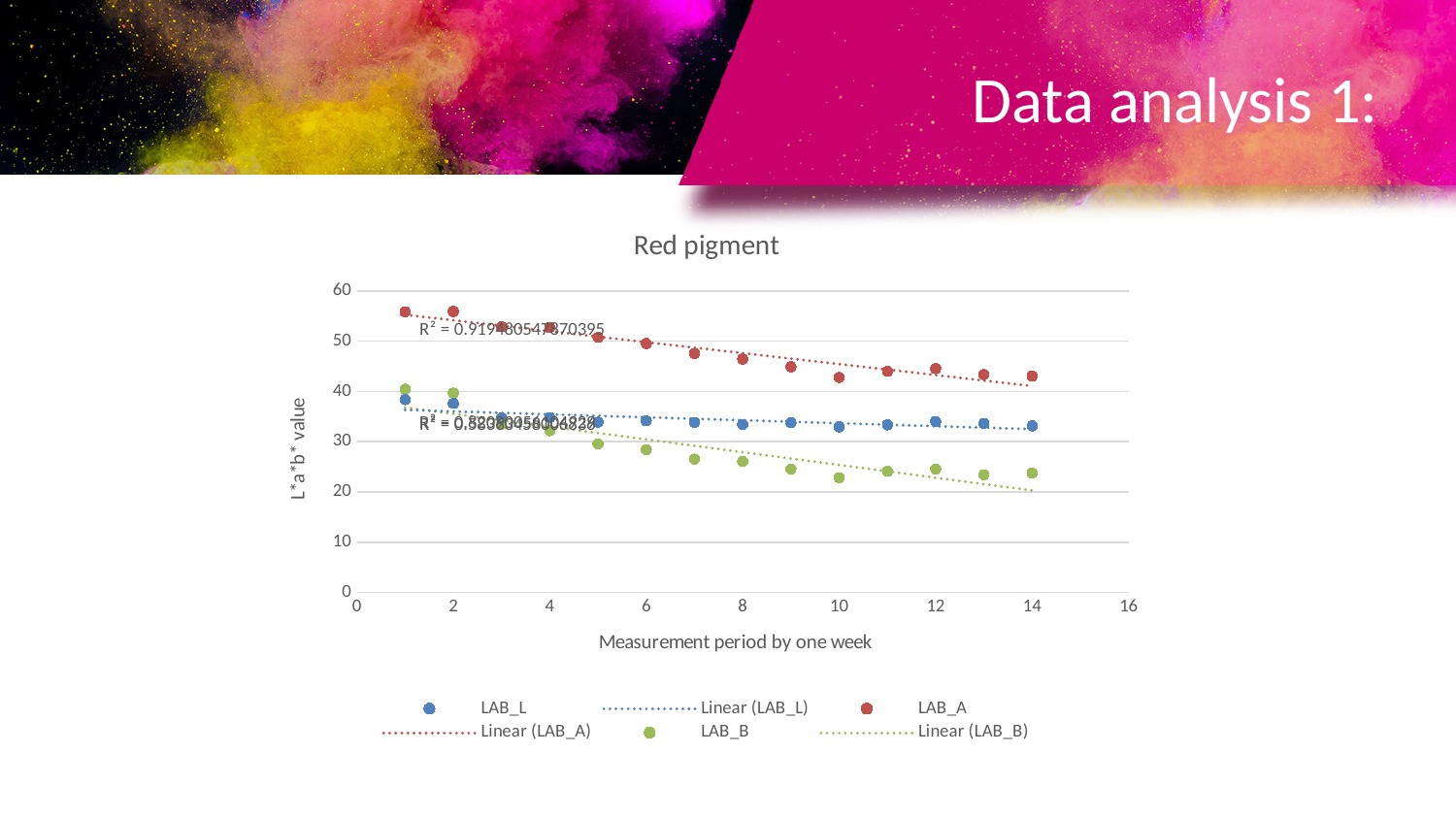
How many entries does the chart's legend list? 6 What is the title of the chart? Red pigment Do the LAB_B values rise or fall as the measurement period increases? fall Which series has the highest values across the measurement period? LAB_A Do the LAB_A values rise or fall as the measurement period increases? fall Is the LAB_L value at week 14 greater or less than 40? less What is the x-axis title of the chart? Measurement period by one week Is the LAB_A value at week 14 greater or less than 40? greater At week 14, which series has the larger value, LAB_A or LAB_B? LAB_A Is the LAB_B value at week 14 greater or less than 30? less What kind of chart is shown on the slide? scatter chart